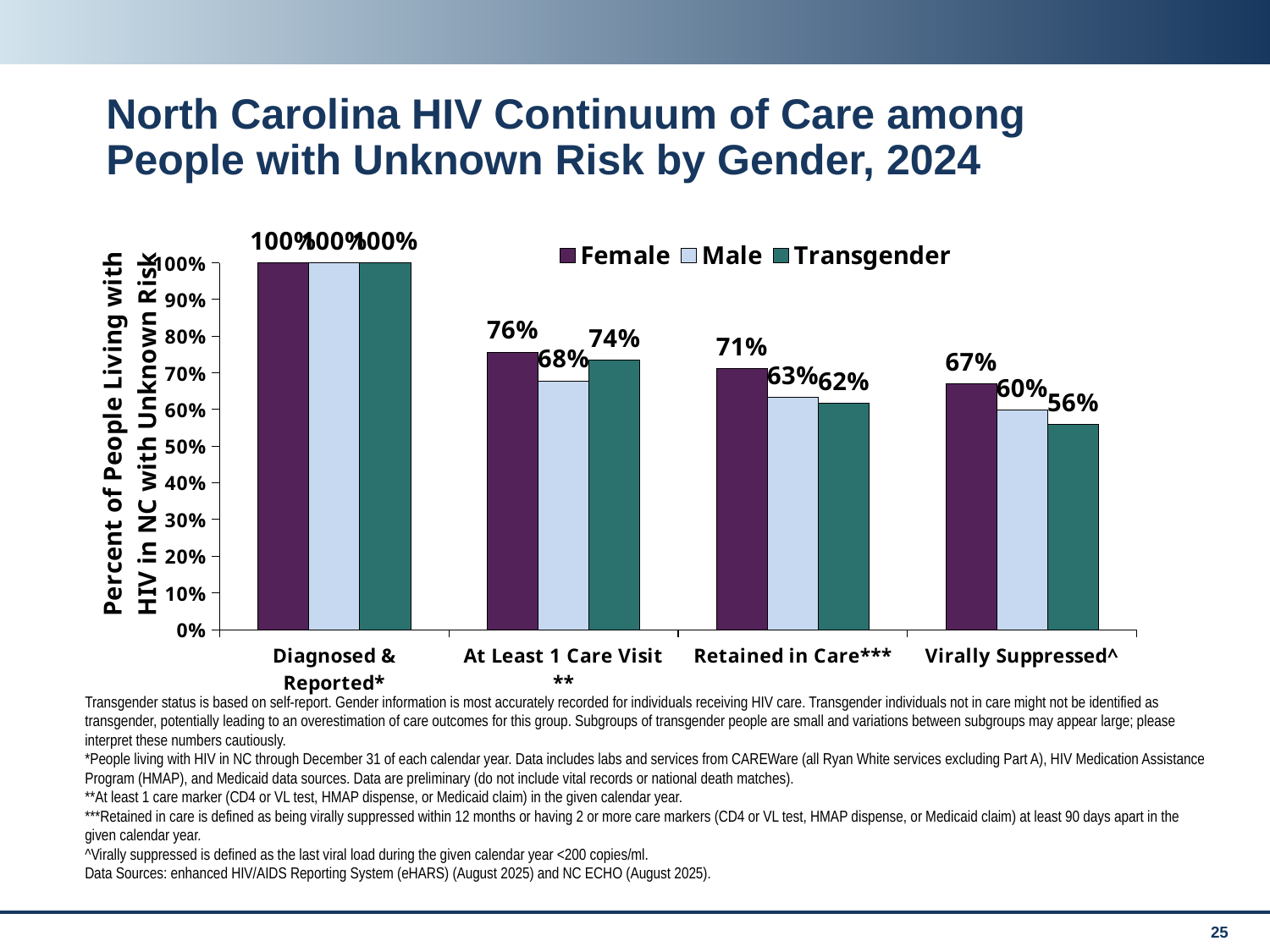
What is the difference between the Female and Male values in the Virally Suppressed category? 7% What is the value for Female in the At Least 1 Care Visit category? 76% How many categories are shown on the x axis? 4 Which series has the lowest value in the Virally Suppressed category? Transgender What is the value for Transgender in the Virally Suppressed category? 56% What kind of chart is shown on the slide? Bar chart Do the Male values rise or fall across the categories from left to right? Fall Which series has the highest value in the At Least 1 Care Visit category? Female Which is larger in the Retained in Care category, the Female value or the Transgender value? Female What is the value for Male in the Retained in Care category? 63% What is the value for Transgender in the At Least 1 Care Visit category? 74% How many series does the legend list? 3